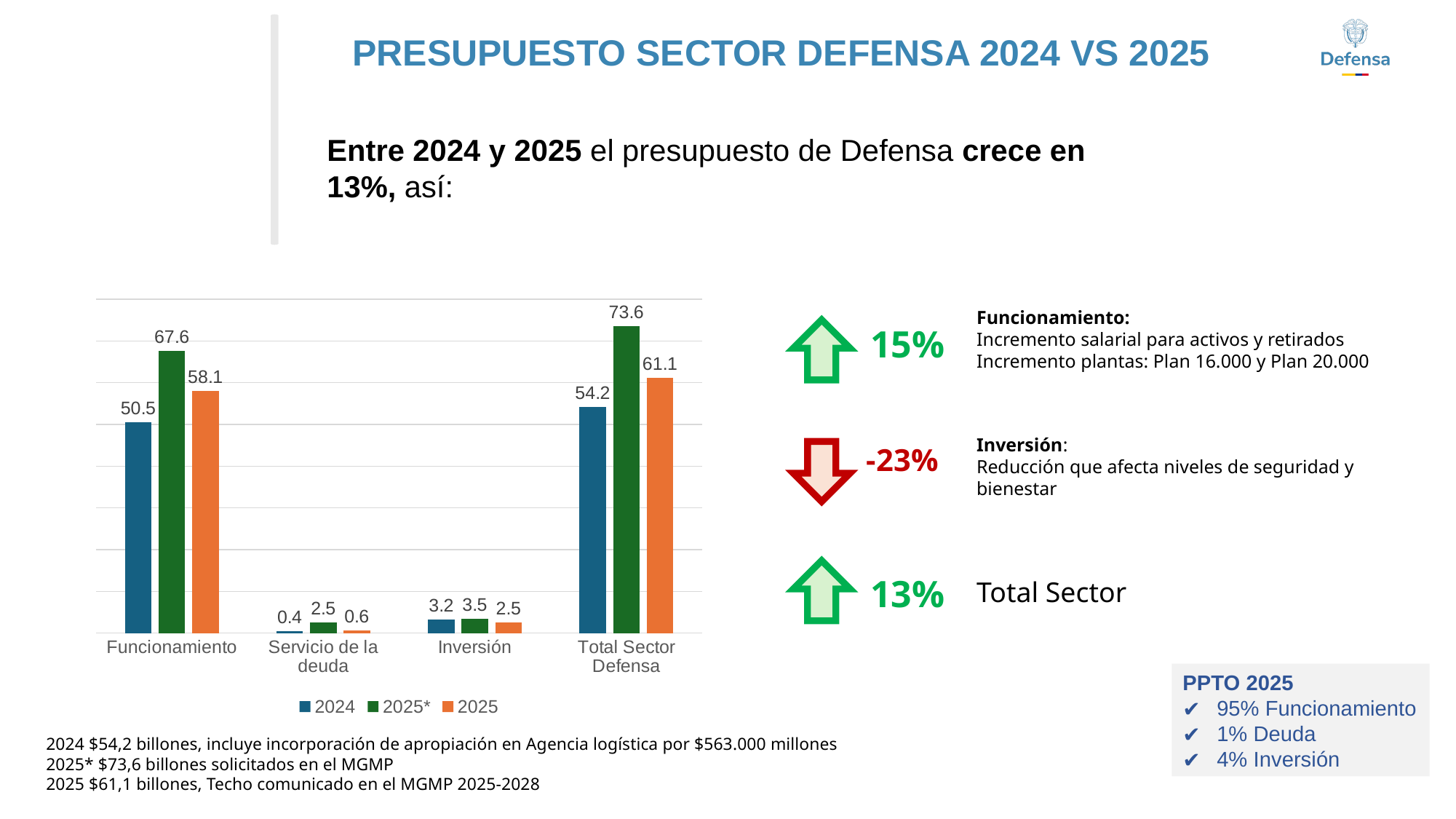
What is the difference between the 2025* and 2024 values for Funcionamiento? 17.1 What is the value for Servicio de la deuda in the 2025* series? 2.5 Which category has the lowest value in the 2024 series? Servicio de la deuda How many series does the chart legend list? 3 What is the value for Total Sector Defensa in the 2025* series? 73.6 What is the value for Inversión in the 2025 series? 2.5 What is the difference between the 2025* and 2025 values for Total Sector Defensa? 12.5 What is the value for Funcionamiento in the 2024 series? 50.5 What kind of chart is shown on the slide? Bar chart Which is larger for Inversión: the 2024 value or the 2025 value? 2024 Which category has the highest value in the 2025 series? Total Sector Defensa How many categories are shown on the x axis of the chart? 4